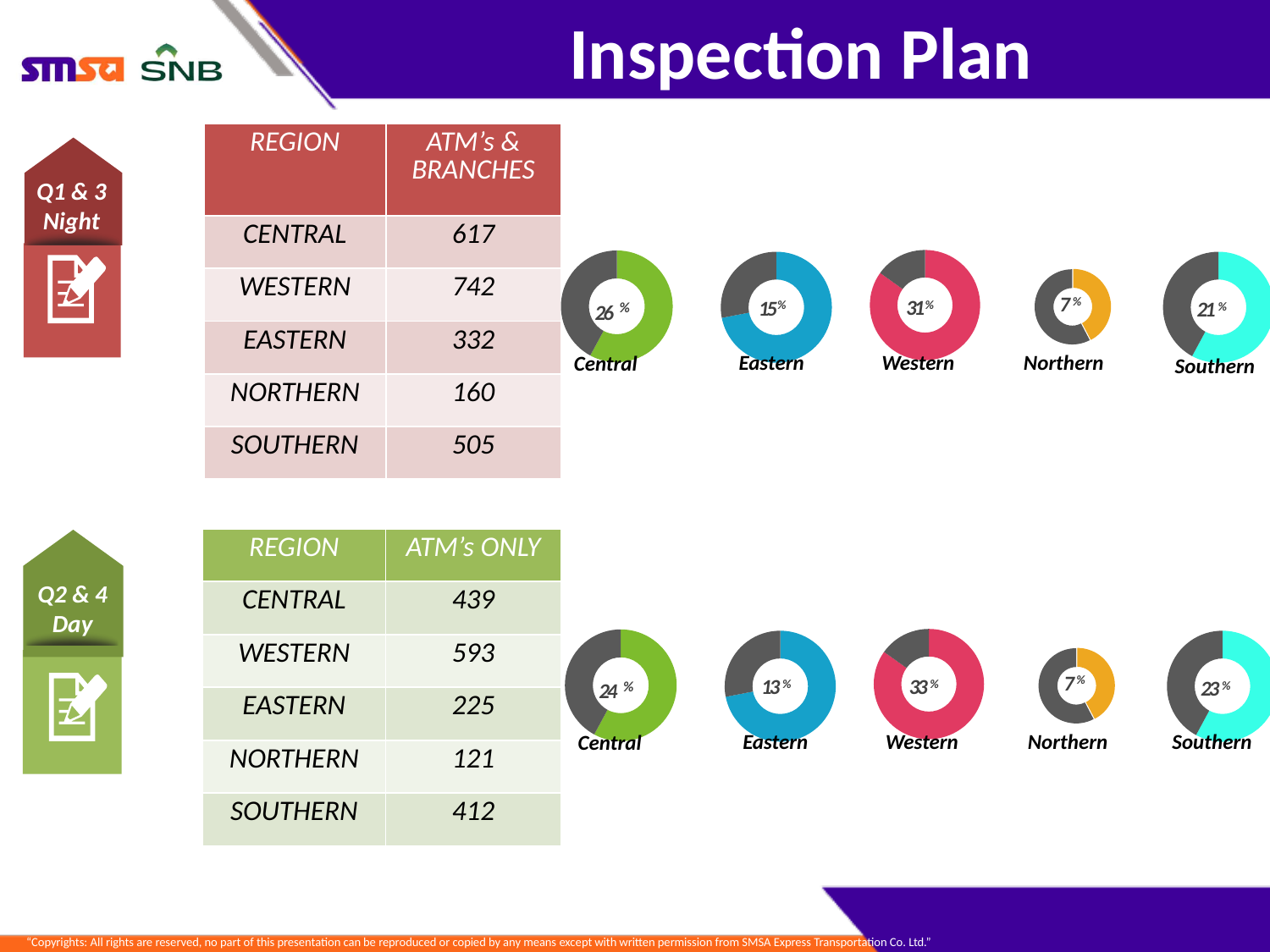
In the top row of donut charts (Q1 & 3 Night), which is larger, the Central percentage or the Southern percentage? Central In the top row of donut charts (Q1 & 3 Night), what percentage is shown in the Central donut? 26% How many donut charts are in the bottom row (Q2 & 4 Day)? 5 In the top row of donut charts (Q1 & 3 Night), what percentage is shown in the Western donut? 31% In the bottom row of donut charts (Q2 & 4 Day), what is the difference between the Central and Northern percentages? 17% Among the bottom row of donut charts (Q2 & 4 Day), which region shows the lowest percentage? Northern In the bottom row of donut charts (Q2 & 4 Day), what percentage is shown in the Eastern donut? 13% What colour is the Western donut chart's main slice in the top row (Q1 & 3 Night)? Pink/red Among the top row of donut charts (Q1 & 3 Night), which region shows the highest percentage? Western What kind of chart is used to show the regional percentages on this slide? Donut chart In the top row of donut charts (Q1 & 3 Night), what is the difference between the Western and Eastern percentages? 16% In the bottom row of donut charts (Q2 & 4 Day), what percentage is shown in the Southern donut? 23%